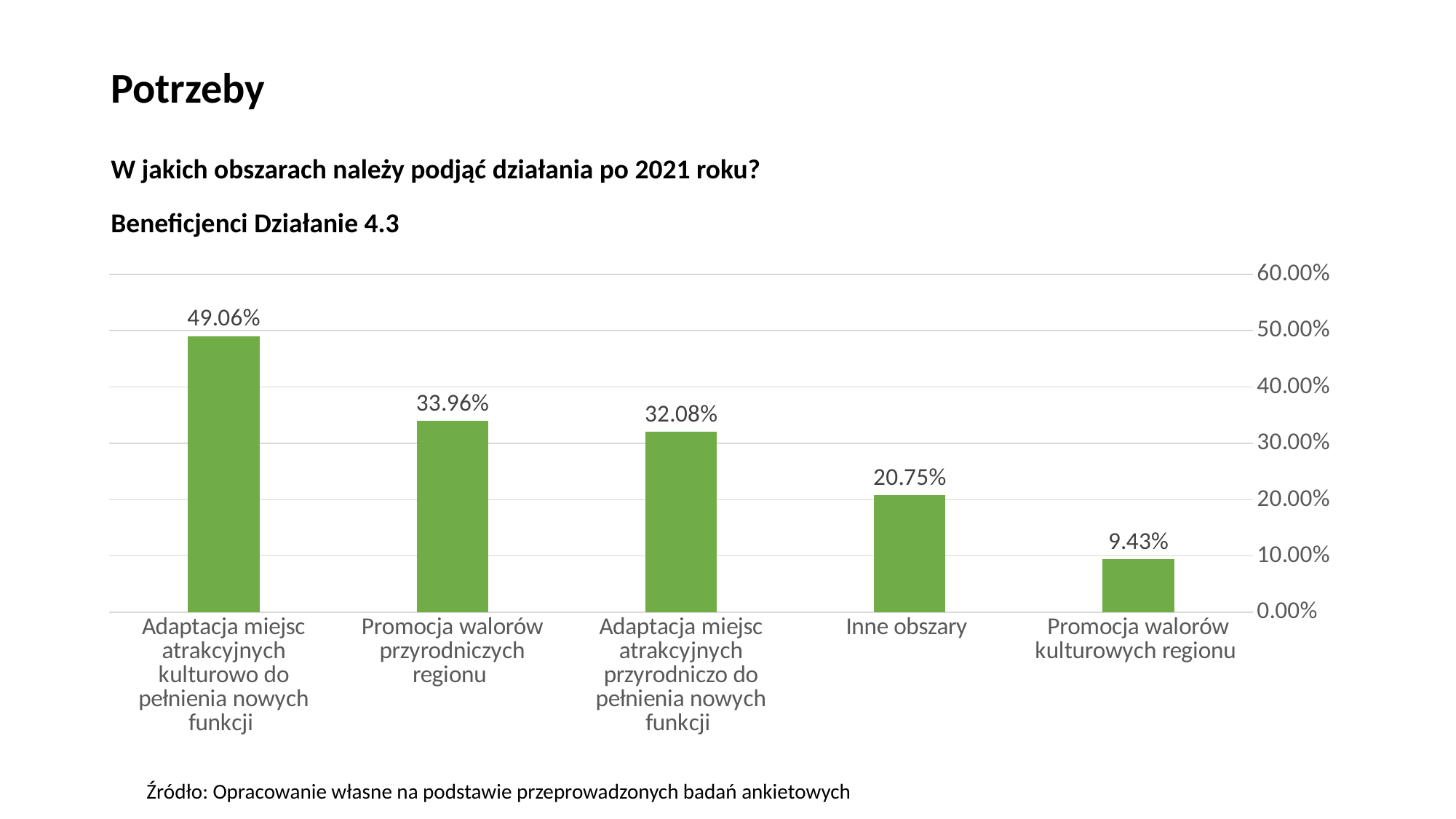
What is the value for "Promocja walorów przyrodniczych regionu"? 33.96% What is the maximum value shown on the vertical axis? 60.00% Which is larger: the value for "Inne obszary" or the value for "Promocja walorów kulturowych regionu"? Inne obszary What kind of chart is shown on the slide? bar chart What is the difference between the values for "Adaptacja miejsc atrakcyjnych kulturowo do pełnienia nowych funkcji" and "Inne obszary"? 28.31% Is the value for "Adaptacja miejsc atrakcyjnych przyrodniczo do pełnienia nowych funkcji" greater or less than 30.00%? greater What is the value for "Promocja walorów kulturowych regionu"? 9.43% Which category has the lowest value? Promocja walorów kulturowych regionu What is the value for "Inne obszary"? 20.75% How many categories are shown in the chart? 5 What is the difference between the values for "Promocja walorów przyrodniczych regionu" and "Adaptacja miejsc atrakcyjnych przyrodniczo do pełnienia nowych funkcji"? 1.88% Which category has the highest value? Adaptacja miejsc atrakcyjnych kulturowo do pełnienia nowych funkcji